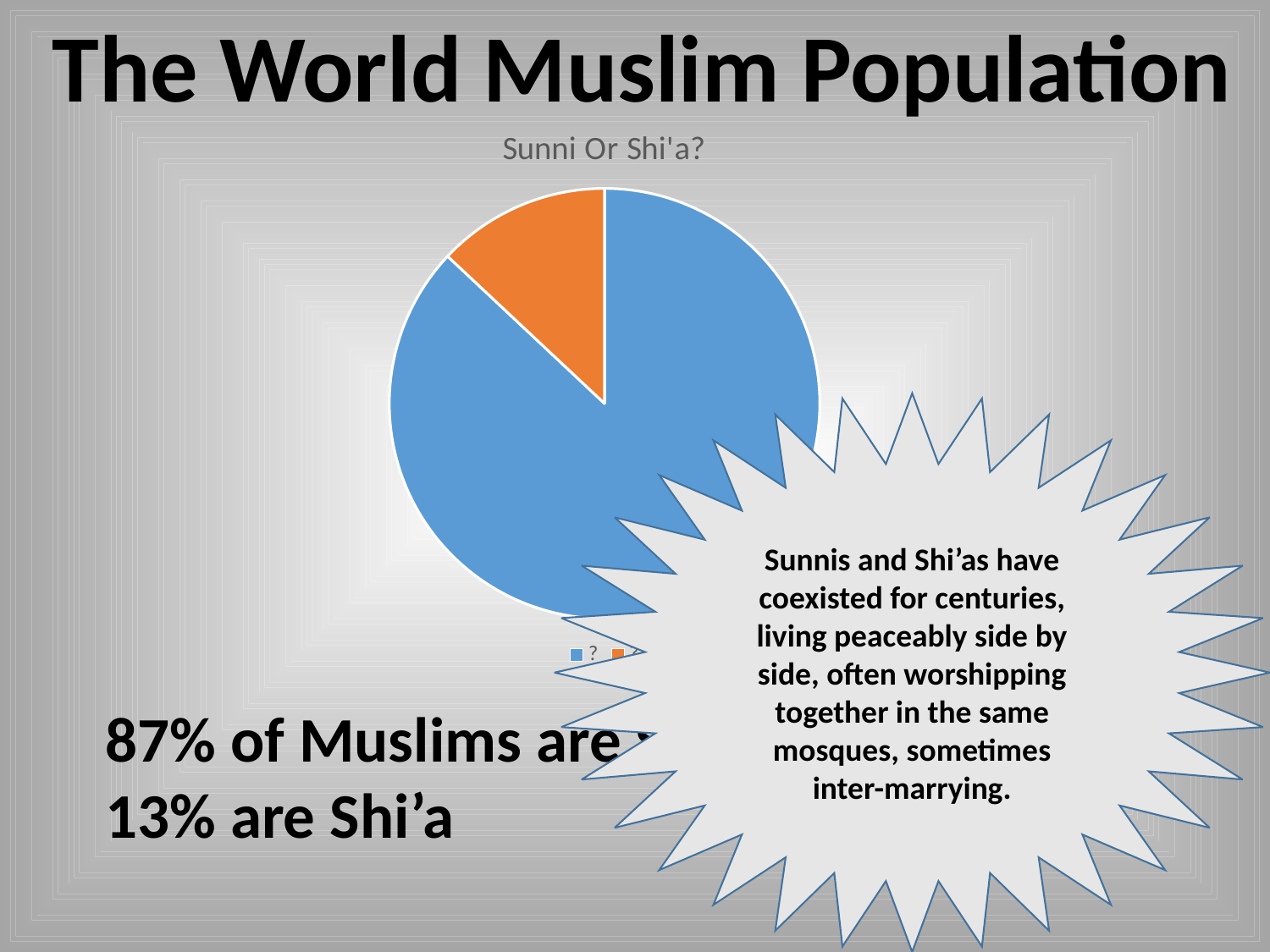
What colour is the larger slice of the pie chart? blue According to the text on the slide, what percentage of Muslims are Shi'a? 13% What is the difference between the two percentages stated on the slide (87% and 13%)? 74% How many slices does the pie chart have? 2 Which slice of the pie chart is larger, the blue one or the orange one? blue Is the orange slice's share of the pie greater or less than 25%? less Which colour slice is the smallest in the pie chart? orange Is the blue slice's share of the pie greater or less than 50%? greater How many entries does the pie chart's legend list? 2 What is the title of the pie chart? Sunni Or Shi'a? According to the text on the slide, what percentage is given for the larger group of Muslims? 87% What kind of chart is shown on the slide? pie chart